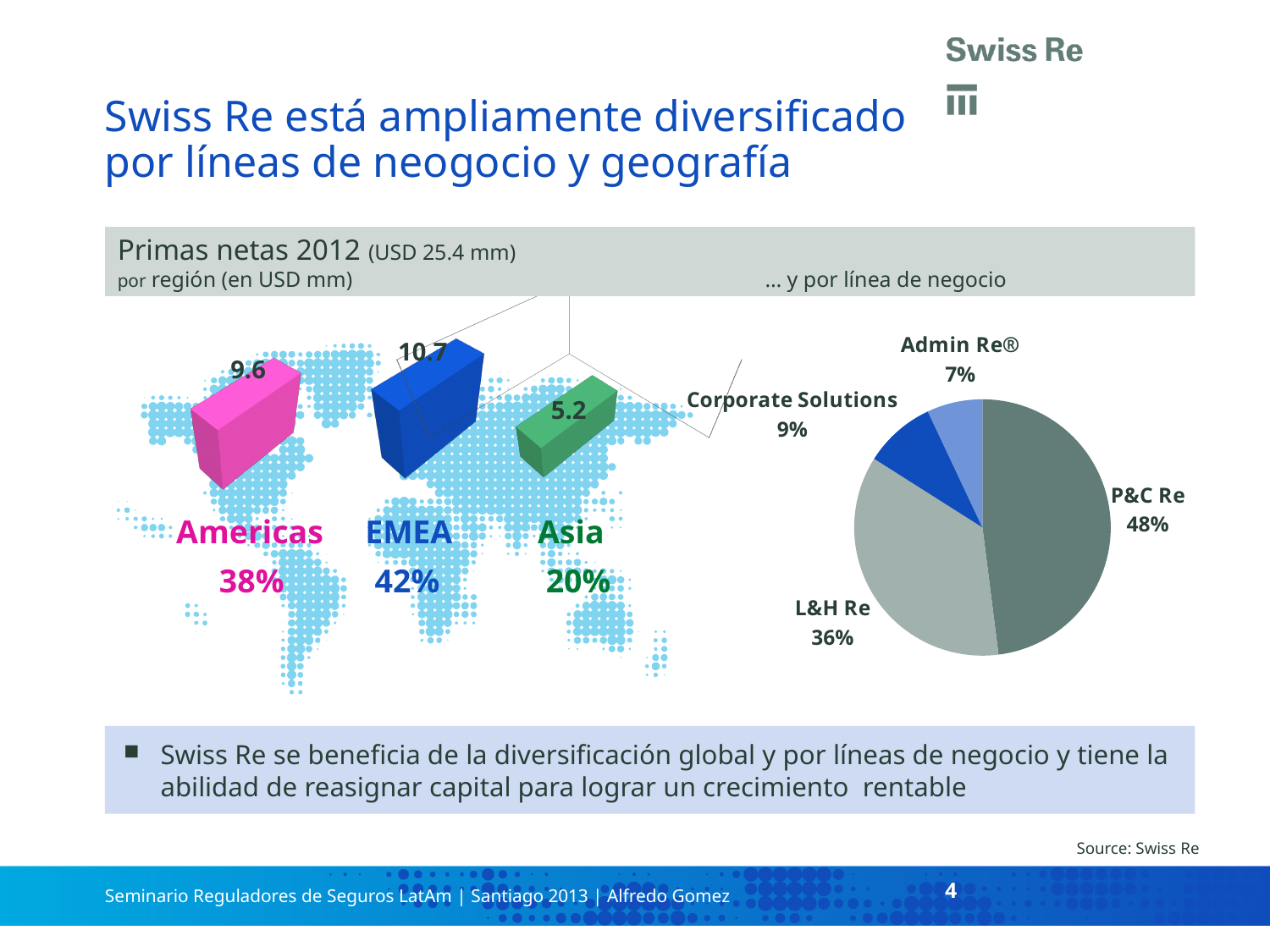
What kind of chart is the chart on the right showing lines of business? Pie chart In the bar chart by region, how many regions are shown? 3 In the bar chart by region, what is the value for EMEA? 10.7 In the bar chart by region, what is the value for Asia? 5.2 In the bar chart by region, which region has the highest value? EMEA In the pie chart by line of business, what share does P&C Re have? 48% In the pie chart by line of business, what share does Admin Re® have? 7% In the bar chart by region, what is the difference between the values for EMEA and Americas? 1.1 In the pie chart by line of business, which line of business has the smallest slice? Admin Re® In the bar chart by region, which region has the lowest value? Asia In the pie chart by line of business, which is larger, L&H Re or Corporate Solutions? L&H Re In the bar chart by region, what percentage share is shown for Americas? 38%